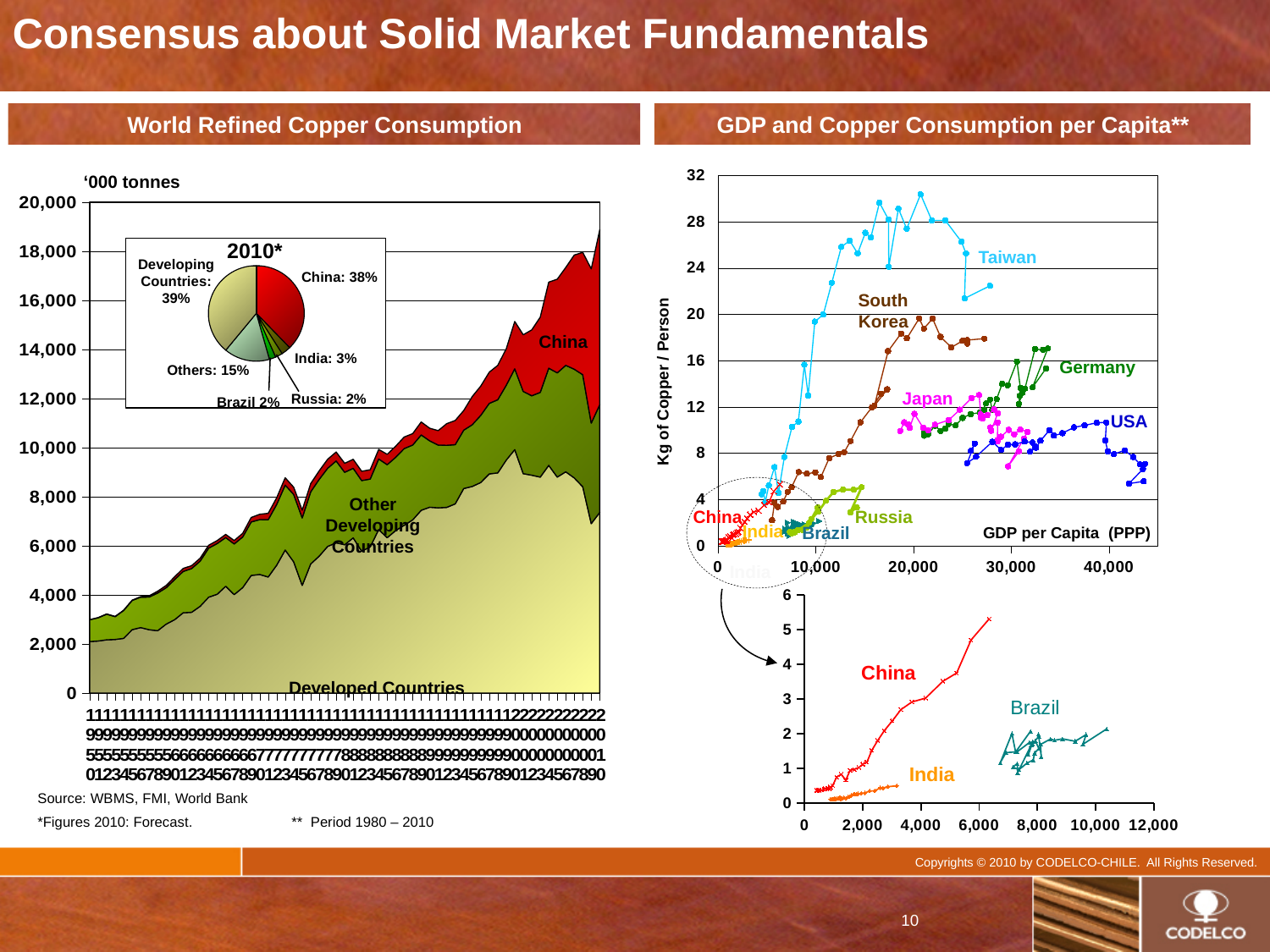
In the World Refined Copper Consumption chart, is total consumption at the end of the series (2010) greater or less than 16,000 thousand tonnes? greater In the GDP and Copper Consumption per Capita chart, is the highest GDP per capita reached by the USA greater or less than 40,000? greater In the GDP and Copper Consumption per Capita chart, which country reaches the highest kg of copper per person? Taiwan In the 2010* pie inset of the World Refined Copper Consumption chart, what is the difference between China's share and India's share? 35% In the World Refined Copper Consumption chart, what share of 2010* consumption does China account for in the pie inset? 38% In the World Refined Copper Consumption chart, does total consumption generally rise or fall from 1950 to 2010? Rise In the 2010* pie inset, which is larger, the share for Others or the share for Russia? Others In the 2010* pie inset of the World Refined Copper Consumption chart, which slice is the largest? Developing Countries How many slices does the 2010* pie inset in the World Refined Copper Consumption chart have? 6 How many series are labelled in the main World Refined Copper Consumption area chart? 3 What kind of chart is the main World Refined Copper Consumption chart? Stacked area chart In the 2010* pie inset of the World Refined Copper Consumption chart, what is the share for Developing Countries? 39%